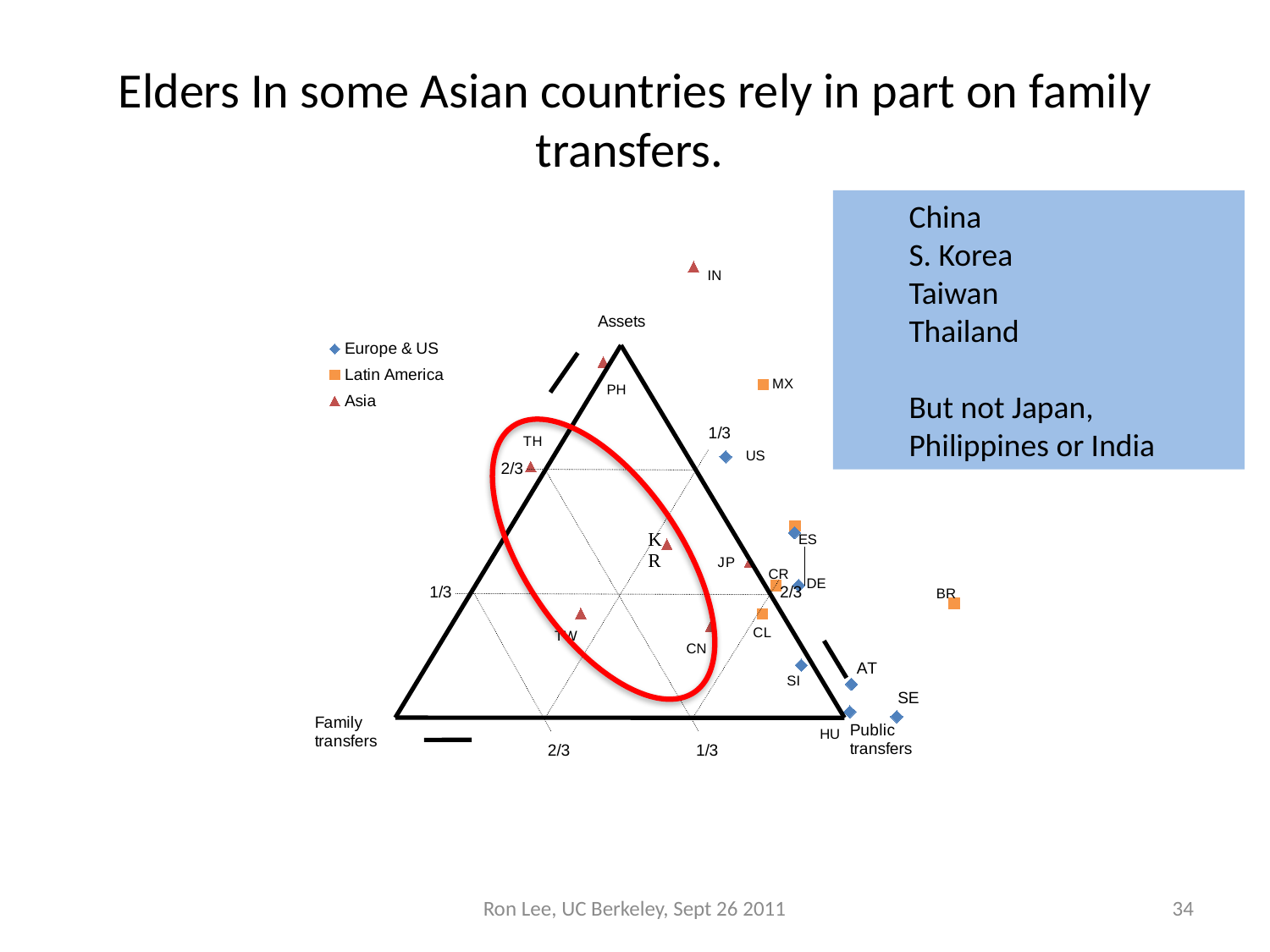
Which labeled point lies closest to the Public transfers vertex? HU Which country labels are enclosed by the red ellipse? TH, KR, TW, CN What kind of chart is shown on the slide? Ternary (triangular) scatter plot What is the label at the bottom-right vertex of the triangle? Public transfers What is the label at the bottom-left vertex of the triangle? Family transfers Which series does the point labeled US belong to? Europe & US What are the three series named in the legend? Europe & US, Latin America, Asia What is the label at the top vertex of the triangle? Assets Which series does the point labeled IN belong to? Asia How many series does the legend list? 3 Which series does the point labeled MX belong to? Latin America